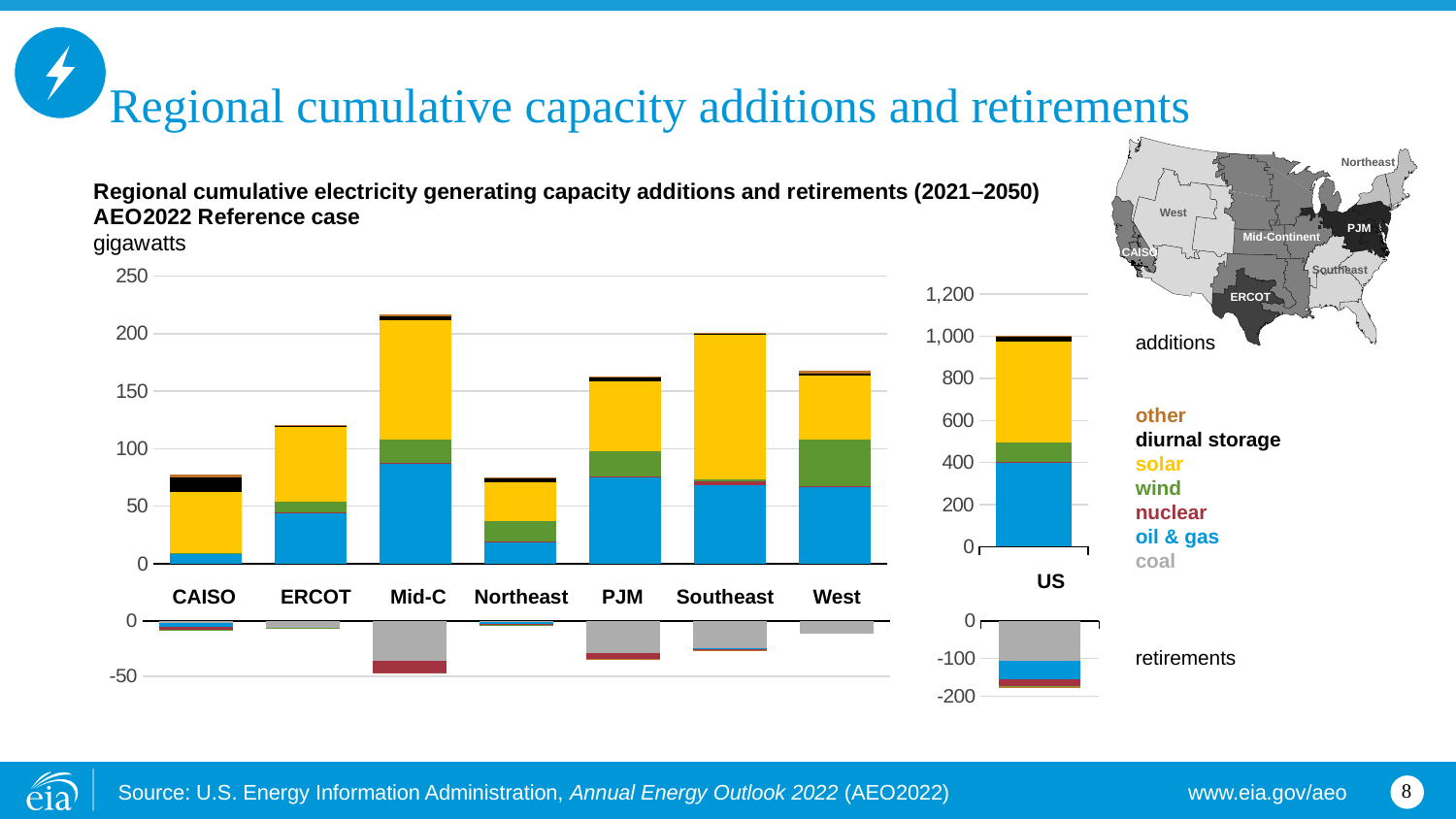
In the US additions chart (top right), is the total additions value for US greater or less than 800? greater What type of chart is used to show the regional additions (top left)? stacked bar chart In the regional additions chart (top left), is the total additions value for ERCOT greater or less than 150? less In the regional additions chart (top left), is the total additions value for Mid-C greater or less than 200? greater In the regional additions chart (top left), which has larger total additions, CAISO or Southeast? Southeast What unit is stated for the values in the charts? gigawatts In the regional retirements chart (bottom left), which region has the largest cumulative retirements? Mid-C How many regions are shown on the x axis of the regional additions chart (top left)? 7 In the regional additions chart (top left), which has larger total additions, ERCOT or PJM? PJM In the regional additions chart (top left), which region has the highest cumulative capacity additions? Mid-C How many series does the legend list? 7